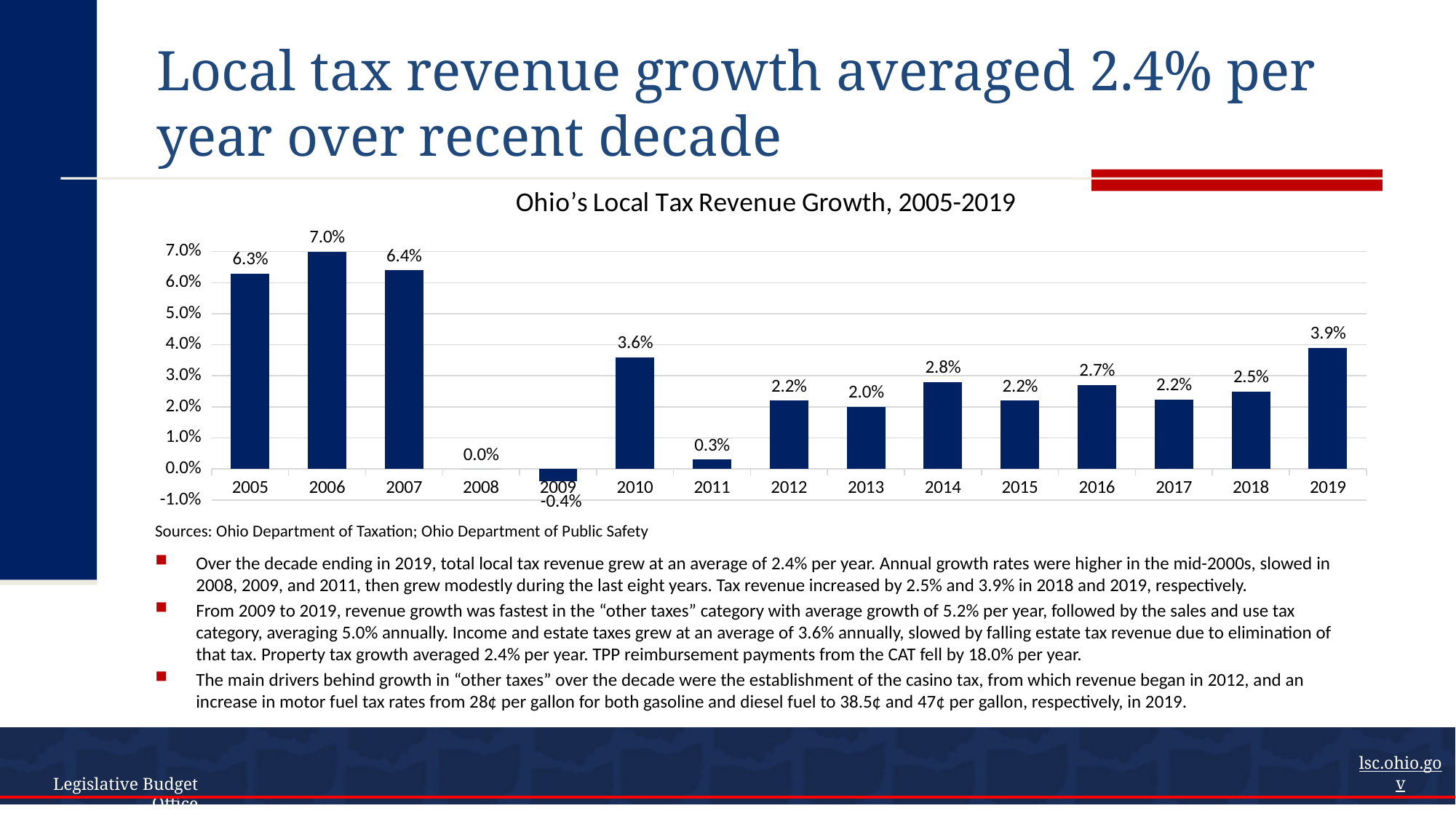
What is the title of the chart? Ohio's Local Tax Revenue Growth, 2005-2019 What was the local tax revenue growth rate in 2009? -0.4% What is the difference between the growth rates in 2007 and 2010? 2.8% Which year had the lowest local tax revenue growth? 2009 What was the local tax revenue growth rate in 2019? 3.9% Did local tax revenue growth rise or fall from 2017 to 2019? Rise Which year had the highest local tax revenue growth? 2006 What type of chart is used to show Ohio's local tax revenue growth? Bar chart What was the local tax revenue growth rate in 2008? 0.0% How many years are shown on the x axis of the chart? 15 Which year had higher growth, 2014 or 2016? 2014 What was Ohio's local tax revenue growth in 2006? 7.0%